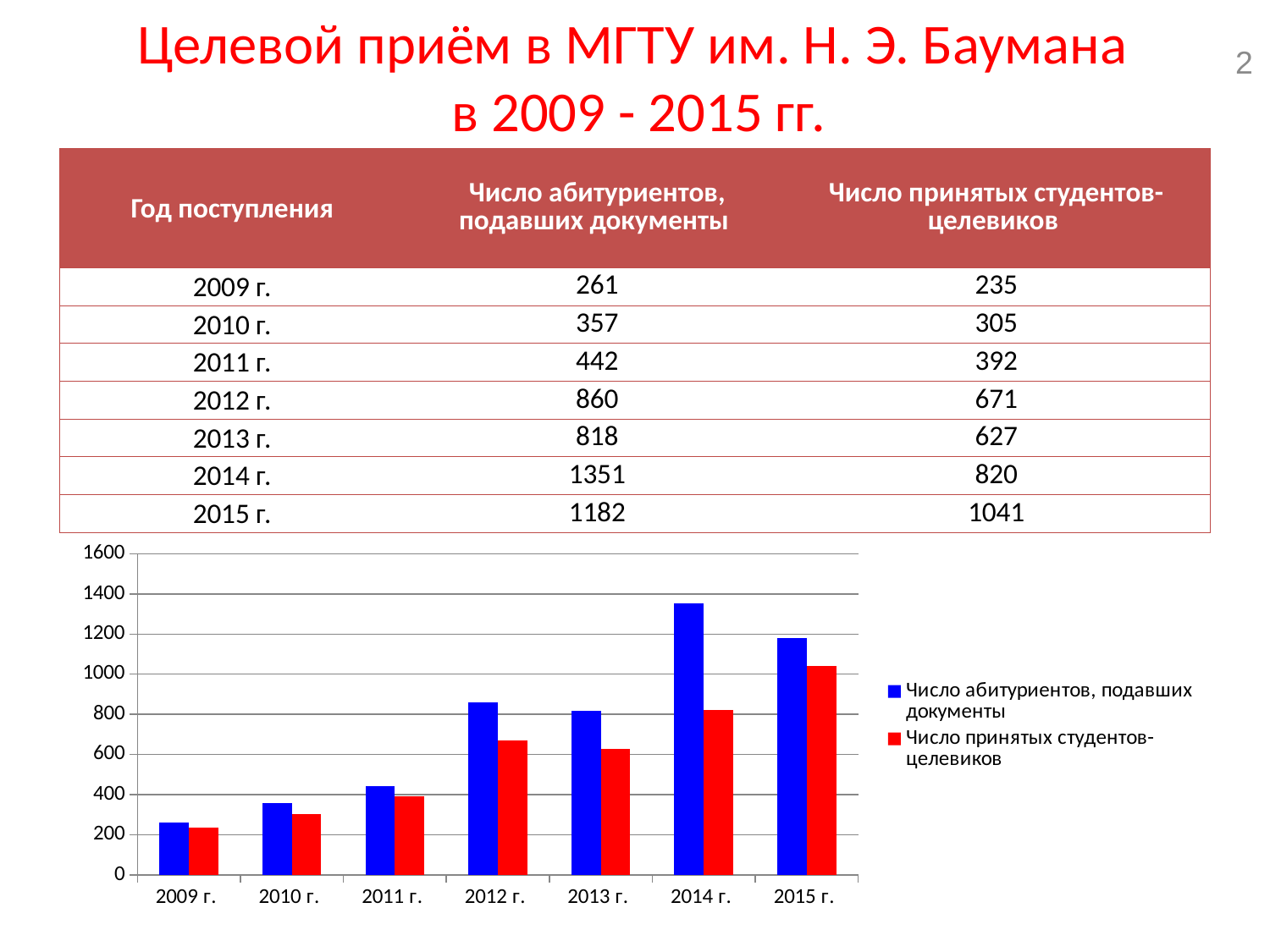
What colour are the bars for 'Число принятых студентов-целевиков'? red What kind of chart is shown on the slide? bar chart Which is larger in 2013 г.: 'Число абитуриентов, подавших документы' or 'Число принятых студентов-целевиков'? Число абитуриентов, подавших документы How many series does the chart legend list? 2 Is the value for 'Число абитуриентов, подавших документы' in 2015 г. greater or less than 1000? greater Which year has the highest value for 'Число абитуриентов, подавших документы'? 2014 г. How many years are shown on the x axis of the chart? 7 Is the value for 'Число принятых студентов-целевиков' in 2011 г. greater or less than 400? less What is the value for 'Число принятых студентов-целевиков' in 2015 г.? 1041 What is the difference between 'Число абитуриентов, подавших документы' and 'Число принятых студентов-целевиков' in 2012 г.? 189 Which year has the lowest value for 'Число принятых студентов-целевиков'? 2009 г. What is the value for 'Число абитуриентов, подавших документы' in 2014 г.? 1351